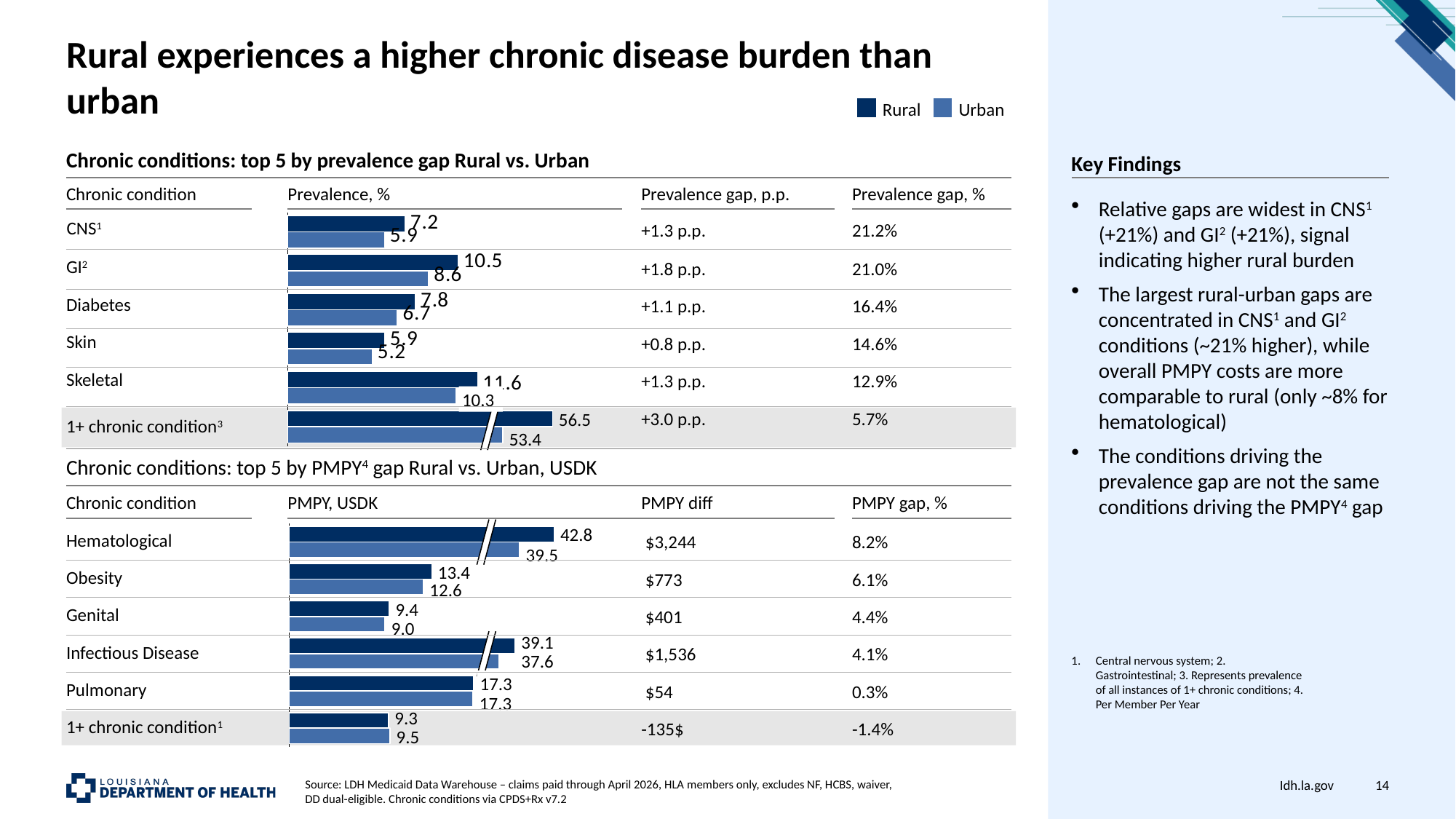
In the top chart (top 5 by prevalence gap), what is the difference between the Rural and Urban prevalence for Skeletal? 1.3 In the top chart (top 5 by prevalence gap), which condition has the lowest Urban prevalence? Skin In the top chart (top 5 by prevalence gap), what is the Urban prevalence for Diabetes? 6.7 How many series does the legend list? 2 In the bottom chart (top 5 by PMPY gap), what is the Rural PMPY for Hematological? 42.8 In the bottom chart (top 5 by PMPY gap), what is the Urban PMPY for Infectious Disease? 37.6 In the bottom chart (top 5 by PMPY gap), what is the difference between the Rural and Urban PMPY for Obesity? 0.8 In the bottom chart (top 5 by PMPY gap), how many chronic condition rows are plotted? 6 In the bottom chart (top 5 by PMPY gap), is the Rural or Urban PMPY larger for the 1+ chronic condition row? Urban In the top chart (top 5 by prevalence gap), which of the five named conditions (excluding the 1+ chronic condition row) has the highest Rural prevalence? Skeletal In the top chart (top 5 by prevalence gap), what is the Rural prevalence for GI? 10.5 What kind of chart is used to show the prevalence and PMPY values on this slide? Bar chart